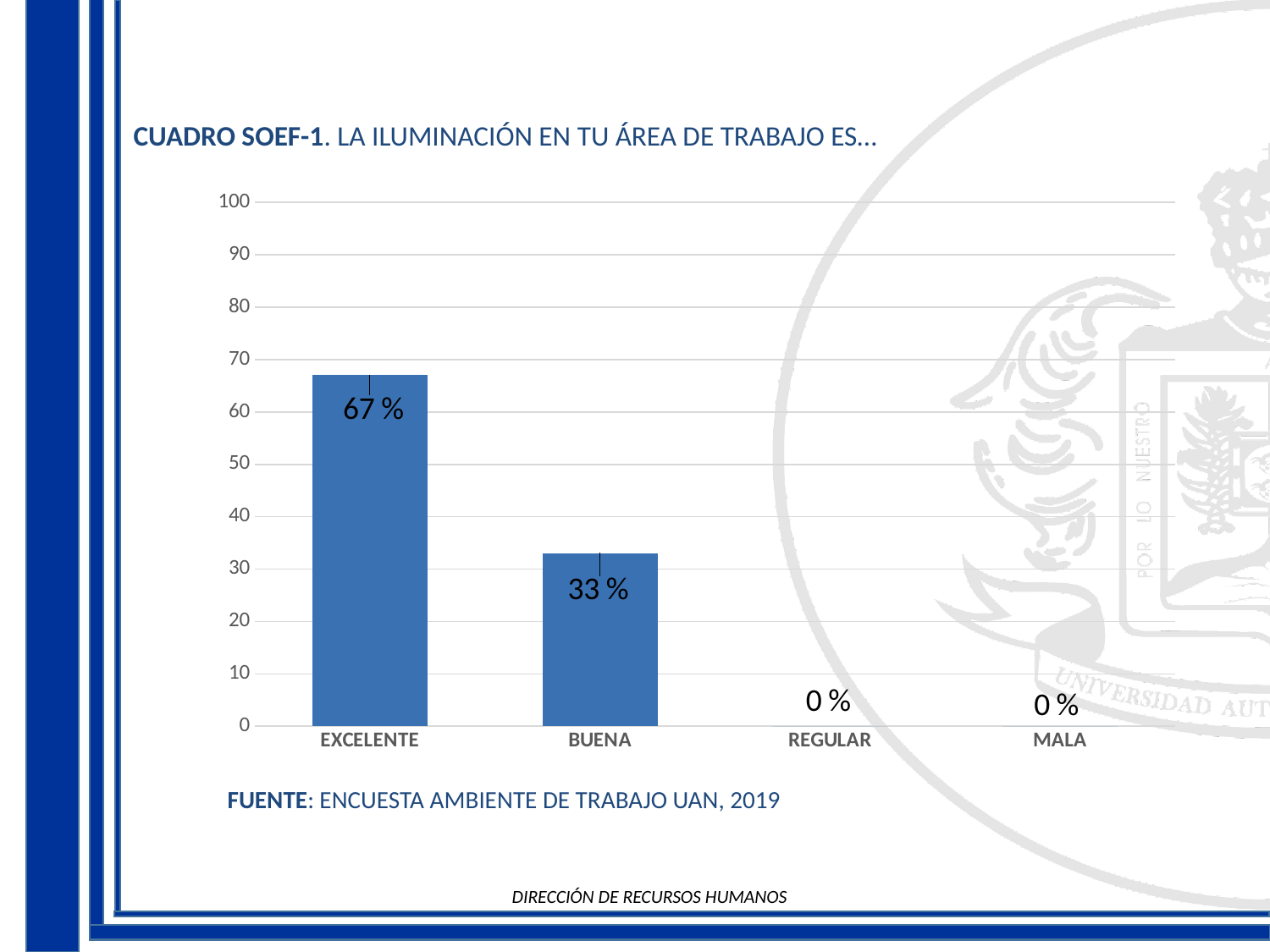
Is the value for EXCELENTE greater or less than 60? greater What is the value for REGULAR? 0 % What is the value for BUENA? 33 % What is the difference between the values for EXCELENTE and BUENA? 34 % Is the value for BUENA greater or less than 40? less What is the value for EXCELENTE? 67 % What kind of chart is shown on the slide? bar chart Which is larger, the value for EXCELENTE or the value for BUENA? EXCELENTE What is the source cited below the chart? ENCUESTA AMBIENTE DE TRABAJO UAN, 2019 How many categories are shown on the x axis? 4 What is the value for MALA? 0 % Which category has the highest value? EXCELENTE